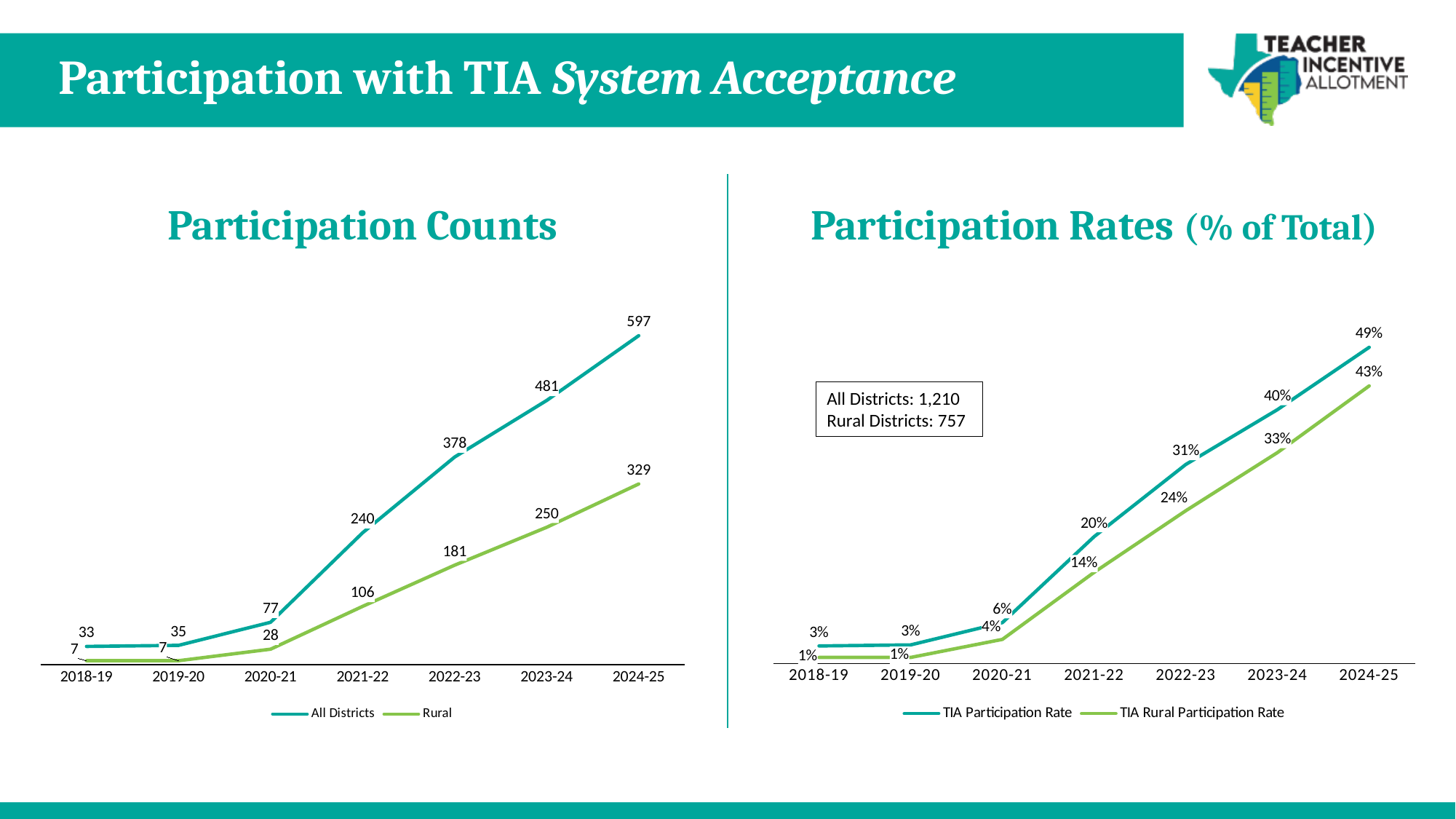
In the Participation Rates chart, is the TIA Participation Rate in 2021-22 larger or smaller than the TIA Rural Participation Rate in 2022-23? smaller In the Participation Counts chart, which year has the lowest Rural value? 2018-19 and 2019-20 (both 7) In the Participation Counts chart, what is the All Districts value for 2024-25? 597 In the Participation Counts chart, what is the Rural value for 2021-22? 106 What type of chart is the Participation Rates chart? Line chart In the Participation Counts chart, how many years are shown on the x axis? 7 In the Participation Rates chart, which year has the highest TIA Participation Rate? 2024-25 In the Participation Rates chart, what is the TIA Participation Rate for 2022-23? 31% In the Participation Rates chart, what is the TIA Rural Participation Rate for 2024-25? 43% In the Participation Rates chart, do the TIA Participation Rate values rise or fall from 2018-19 to 2024-25? Rise In the Participation Counts chart, what is the difference between All Districts and Rural in 2023-24? 231 In the Participation Counts chart, how many series does the legend list? 2